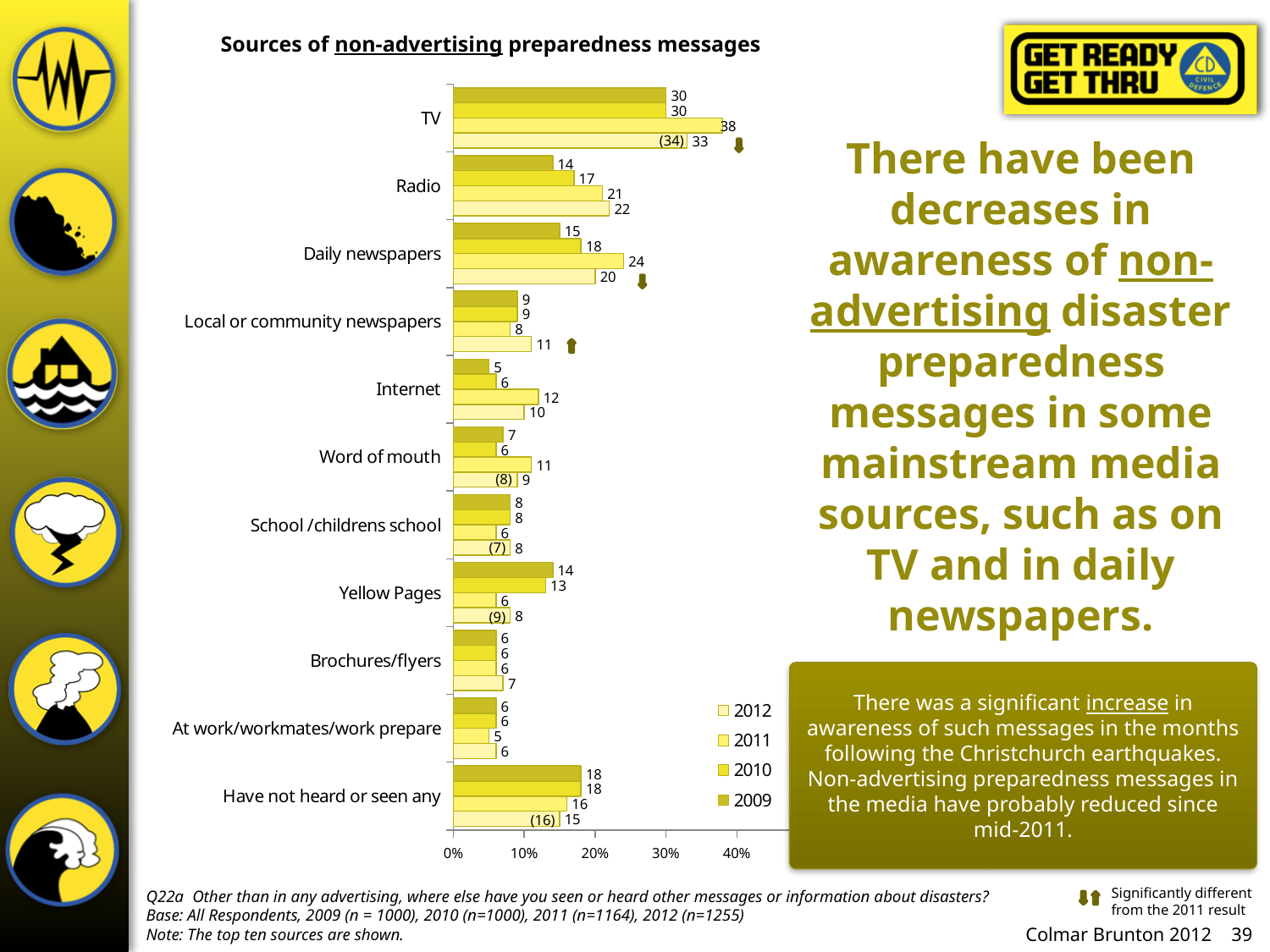
How many series does the legend list? 4 Which source has the lowest 2011 value? At work/workmates/work prepare What is the 2011 value for Internet? 12 What is the difference between the 2011 and 2012 values for TV? 5 Which is larger for Yellow Pages: the 2009 value or the 2012 value? 2009 What is the 2009 value for Daily newspapers? 15 Is the 2011 value for TV greater or less than 30%? greater How many sources are listed on the chart? 11 What is the 2011 value for TV? 38 Which source has the highest 2011 value? TV What is the 2012 value for Radio? 22 What kind of chart is shown on the slide? Bar chart